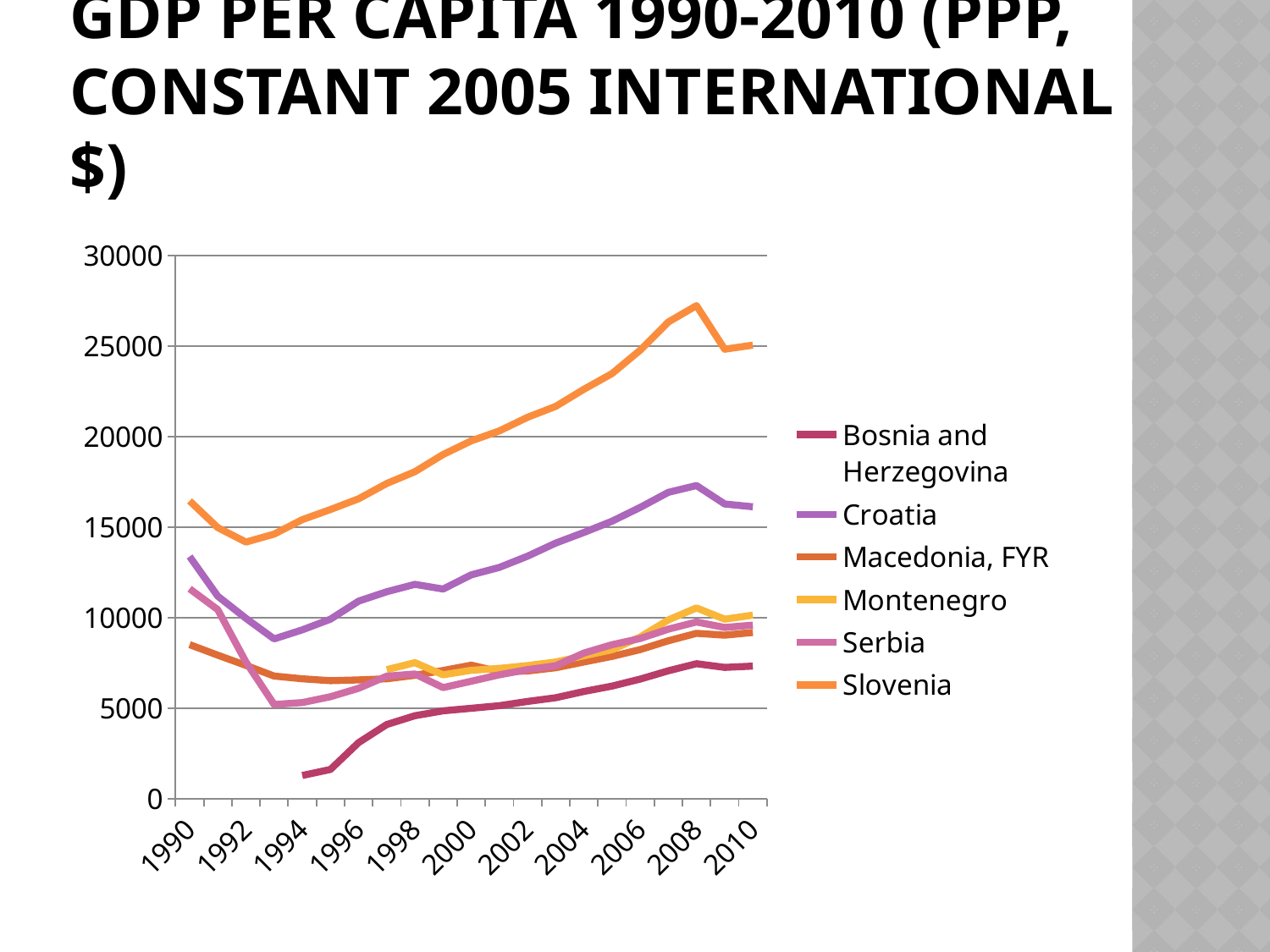
Is the value for Croatia in 2010 greater or less than 15000? greater Does the value for Slovenia rise or fall between 1993 and 2008? rise Which series starts latest on the x axis, with no data before 1997? Montenegro Which country has the lowest GDP per capita in 2010? Bosnia and Herzegovina Is the value for Macedonia, FYR in 1990 greater or less than 10000? less What is the title of the chart? GDP PER CAPITA 1990-2010 (PPP, CONSTANT 2005 INTERNATIONAL $) Which country has the highest GDP per capita across the whole period? Slovenia Is the value for Slovenia in 2008 greater or less than 25000? greater Which is larger in 1990, the value for Croatia or the value for Serbia? Croatia How many series does the legend list? 6 What kind of chart is shown on the slide? line chart